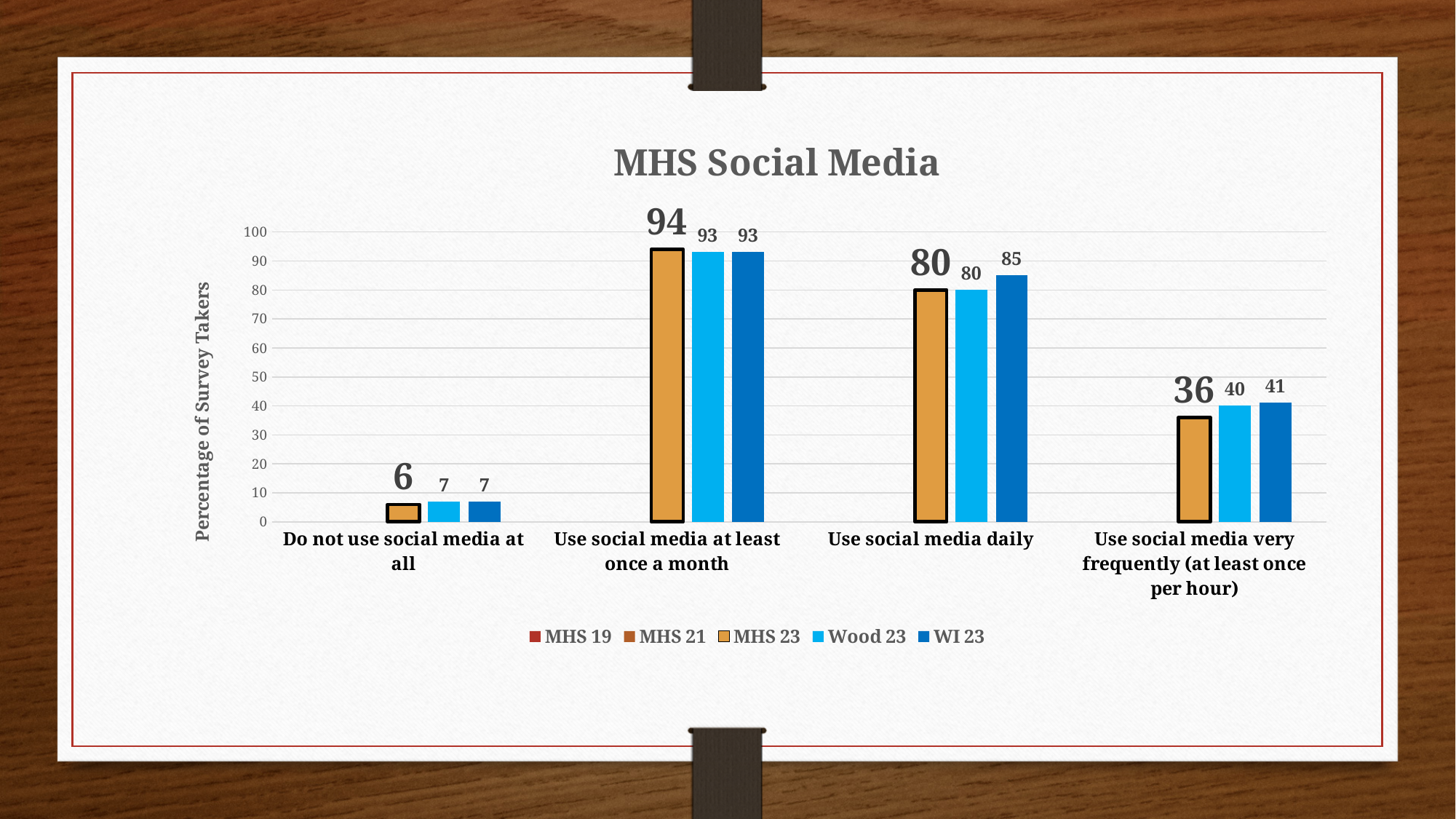
What is the Wood 23 value for 'Use social media very frequently (at least once per hour)'? 40 What kind of chart is shown on the slide? Bar chart What is the difference between the WI 23 and MHS 23 values for 'Use social media very frequently (at least once per hour)'? 5 What is the difference between the WI 23 and MHS 23 values for 'Use social media daily'? 5 What is the MHS 23 value for 'Do not use social media at all'? 6 Which category has the lowest WI 23 value? Do not use social media at all What is the WI 23 value for 'Use social media daily'? 85 What is the MHS 23 value for 'Use social media at least once a month'? 94 How many series does the legend list? 5 How many categories are shown on the x axis? 4 Which category has the highest MHS 23 value? Use social media at least once a month For 'Use social media very frequently (at least once per hour)', which is larger: the MHS 23 value or the WI 23 value? WI 23